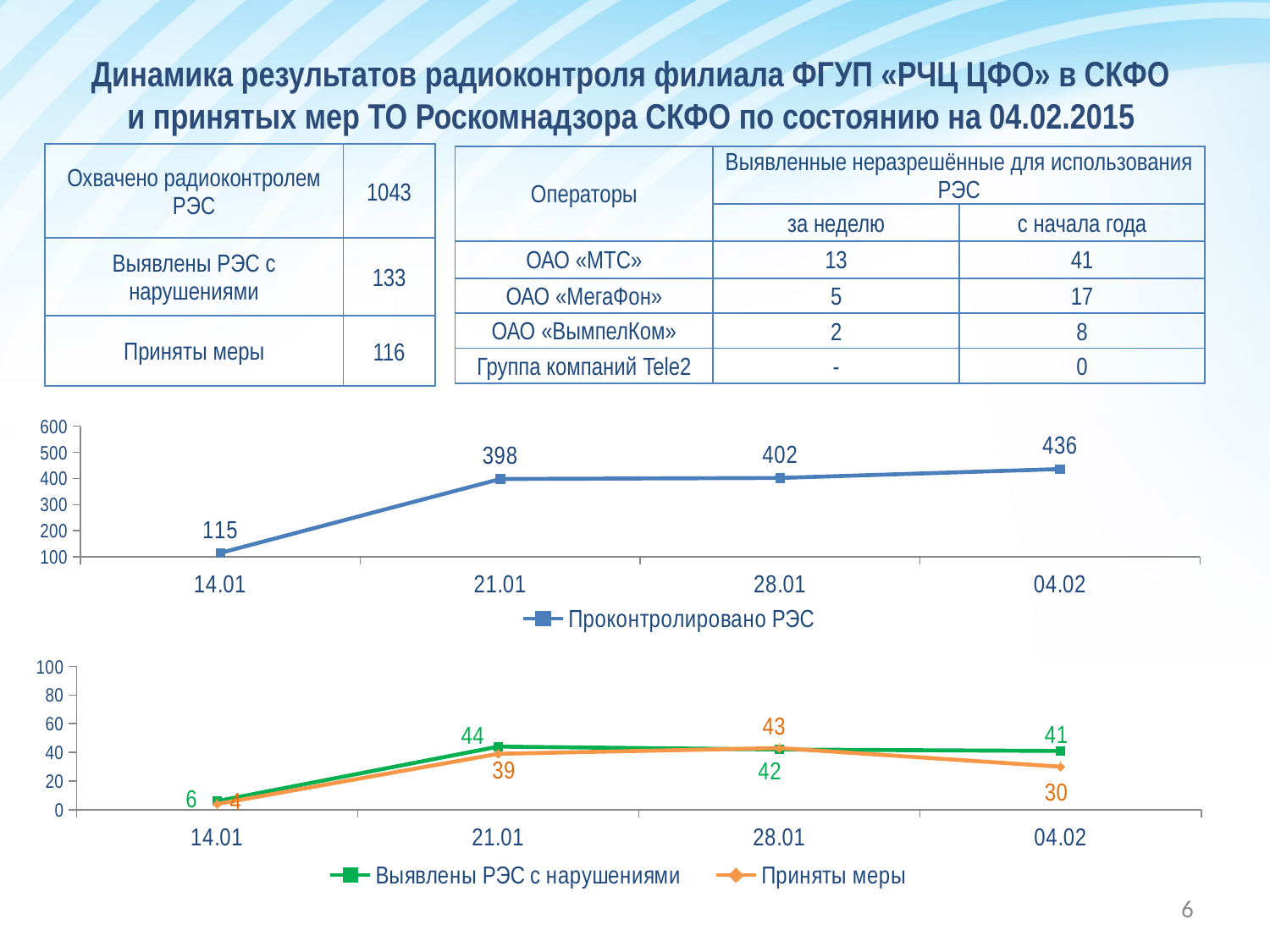
In the lower chart, what is the difference between Выявлены РЭС с нарушениями and Приняты меры for 04.02? 11 In the upper chart (Проконтролировано РЭС), which date has the highest value? 04.02 In the upper chart (Проконтролировано РЭС), what is the difference between the values for 04.02 and 14.01? 321 What type of chart is the upper chart (Проконтролировано РЭС)? line chart In the upper chart (Проконтролировано РЭС), how many data points are plotted? 4 In the lower chart, which is larger for 04.02: Выявлены РЭС с нарушениями or Приняты меры? Выявлены РЭС с нарушениями In the lower chart, what is the value of Выявлены РЭС с нарушениями for 21.01? 44 In the upper chart (Проконтролировано РЭС), which date has the lowest value? 14.01 In the upper chart (Проконтролировано РЭС), do the values rise or fall from 14.01 to 04.02? rise In the lower chart, how many series does the legend list? 2 In the upper chart (Проконтролировано РЭС), what is the value for 21.01? 398 In the lower chart, what is the value of Приняты меры for 28.01? 43